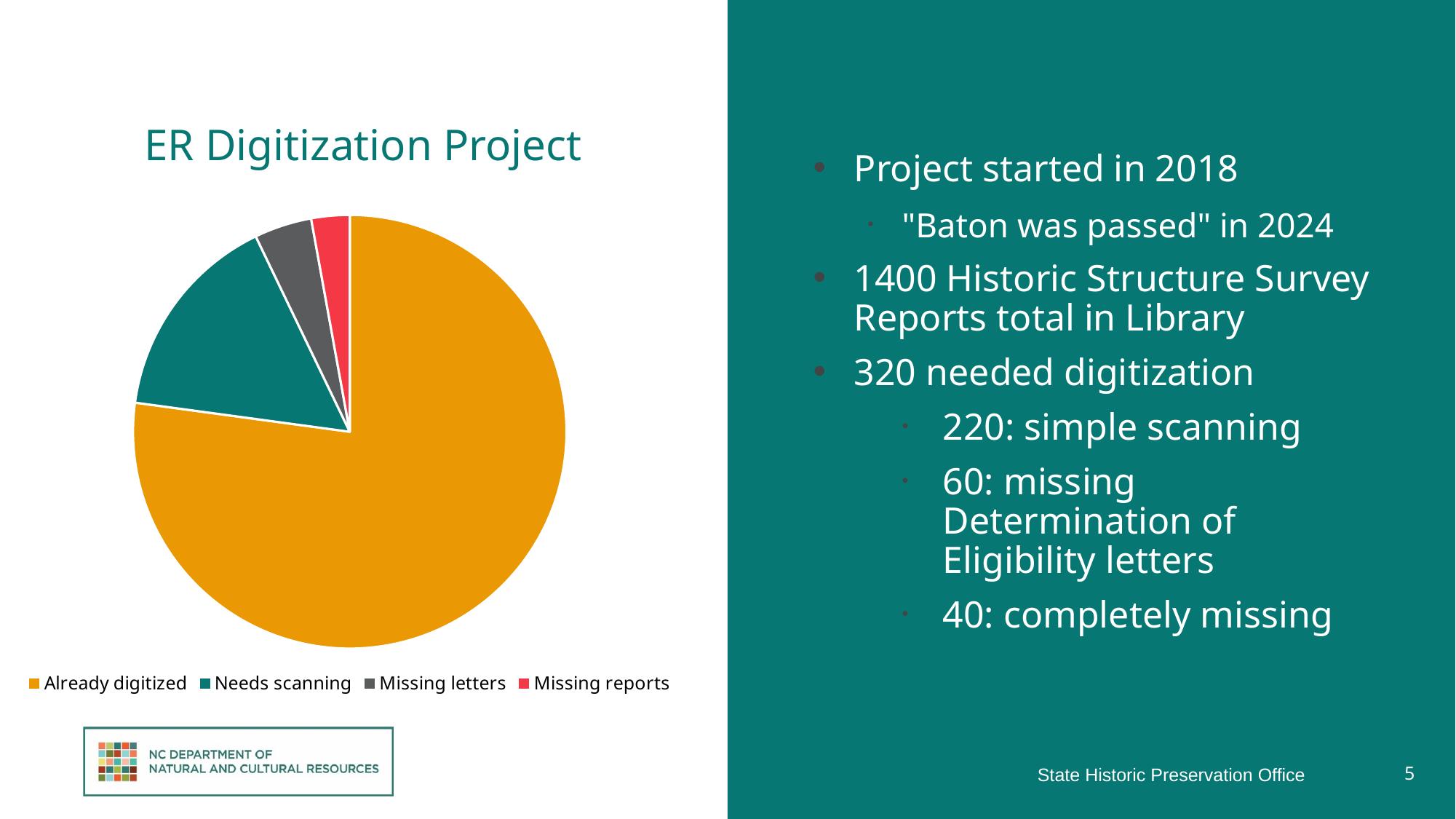
Which category has the smallest slice of the pie? Missing reports Which slice is larger: Needs scanning or Missing letters? Needs scanning How many slices does the pie chart have? 4 What colour is the Already digitized slice? orange Which category has the largest slice of the pie? Already digitized Which slice is larger: Missing letters or Missing reports? Missing letters Which slice is larger: Already digitized or Needs scanning? Already digitized What is the title of the chart? ER Digitization Project What kind of chart is shown on the slide? pie chart How many entries does the chart legend list? 4